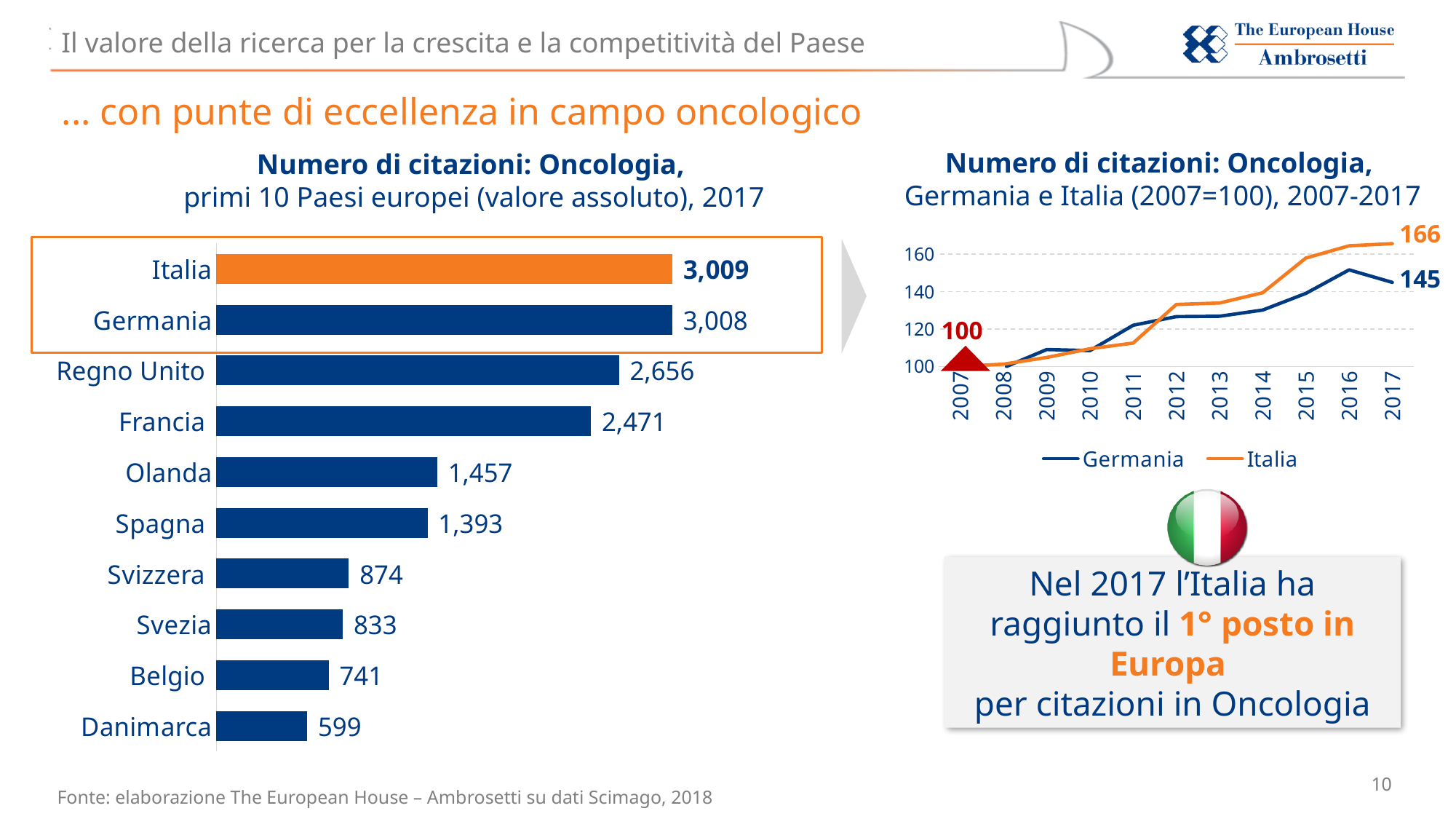
In the right chart 'Numero di citazioni: Oncologia, Germania e Italia (2007=100)', what is the value for Italia in 2017? 166 In the left chart 'Numero di citazioni: Oncologia, primi 10 Paesi europei', what is the difference between the values for Francia and Spagna? 1,078 How many countries are shown in the left chart 'Numero di citazioni: Oncologia, primi 10 Paesi europei'? 10 In the left chart 'Numero di citazioni: Oncologia, primi 10 Paesi europei', which country has the lowest number of citations? Danimarca In the left chart 'Numero di citazioni: Oncologia, primi 10 Paesi europei', which country has the highest number of citations? Italia In the left chart 'Numero di citazioni: Oncologia, primi 10 Paesi europei', what is the value for Olanda? 1,457 In the right chart 'Numero di citazioni: Oncologia, Germania e Italia (2007=100)', what is the value for Germania in 2017? 145 How many series does the legend of the right chart 'Numero di citazioni: Oncologia, Germania e Italia (2007=100)' list? 2 In the left chart 'Numero di citazioni: Oncologia, primi 10 Paesi europei', what is the difference between the values for Italia and Germania? 1 In the left chart 'Numero di citazioni: Oncologia, primi 10 Paesi europei', which has a larger value, Svizzera or Belgio? Svizzera What kind of chart is the left chart 'Numero di citazioni: Oncologia, primi 10 Paesi europei'? Bar chart In the left chart 'Numero di citazioni: Oncologia, primi 10 Paesi europei', what is the value for Regno Unito? 2,656